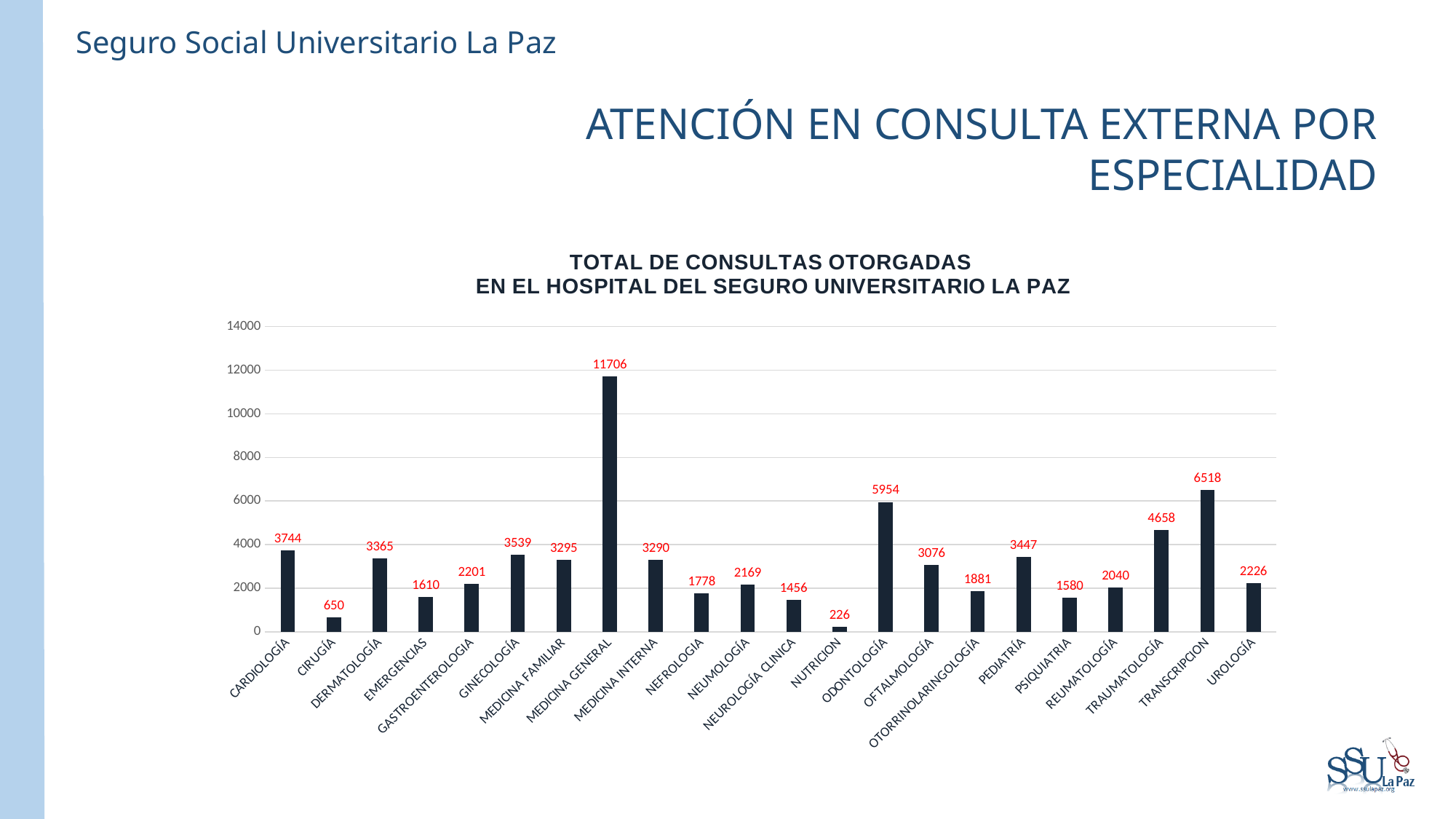
What is the value shown for NUTRICION? 226 Which has more consultations, TRAUMATOLOGÍA or ODONTOLOGÍA? ODONTOLOGÍA Which specialty has the lowest number of consultations? NUTRICION What is the difference between the values for CARDIOLOGÍA and CIRUGÍA? 3094 What kind of chart is shown on the slide? Bar chart What is the value shown for ODONTOLOGÍA? 5954 How many consultations were given in MEDICINA GENERAL? 11706 How many specialties are shown on the x axis of the chart? 22 What is the difference between the values for MEDICINA GENERAL and TRANSCRIPCION? 5188 Is the value for TRANSCRIPCION greater or less than 6000? greater Which specialty has the highest number of consultations? MEDICINA GENERAL What is the title of the chart? TOTAL DE CONSULTAS OTORGADAS EN EL HOSPITAL DEL SEGURO UNIVERSITARIO LA PAZ